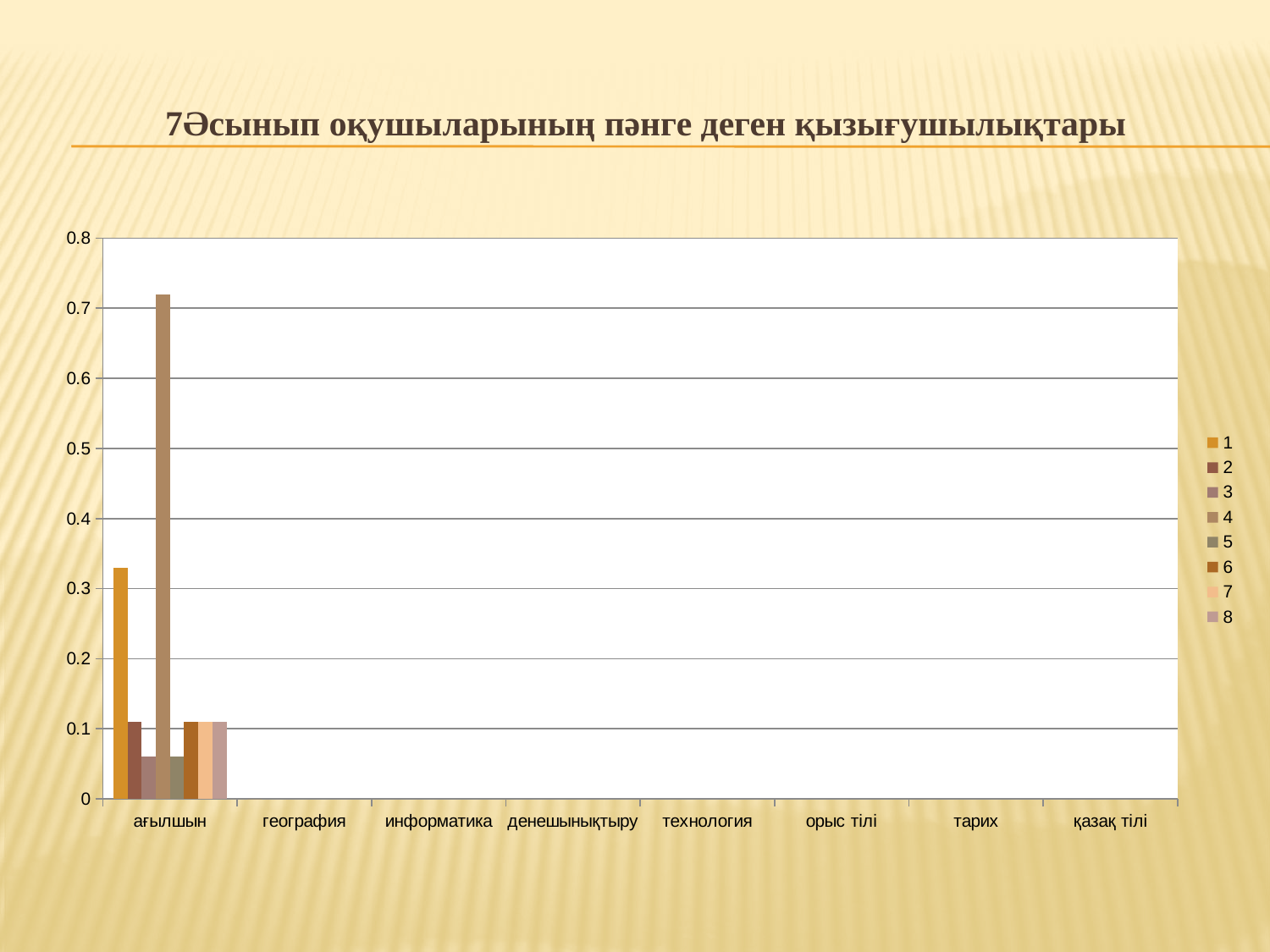
Is the value of series 1 for ағылшын greater or less than 0.3? greater How many categories are shown on the x axis of the chart? 8 What is the title of the chart on the slide? 7Әсынып оқушыларының пәнге деген қызығушылықтары For ағылшын, which is larger: the value of series 1 or series 2? series 1 For ағылшын, which is larger: the value of series 4 or series 1? series 4 What kind of chart is shown on the slide? bar chart Is the value of series 4 for ағылшын greater or less than 0.7? greater How many series does the chart's legend list? 8 Which category on the x axis is the only one with visible bars? ағылшын Is the value of series 4 for ағылшын greater or less than 0.8? less Which series has the tallest bar for ағылшын? 4